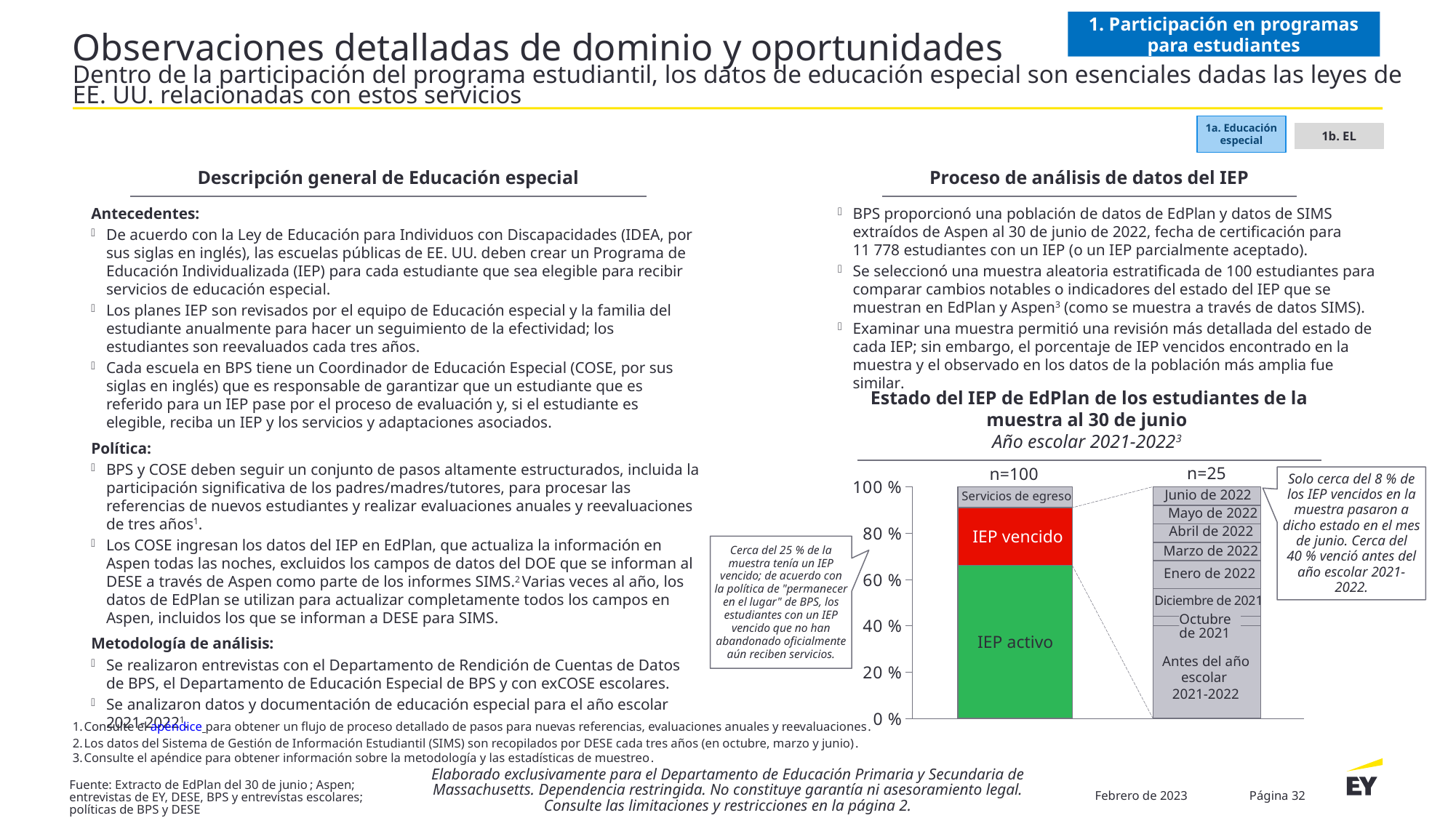
What kind of chart is shown on the slide? Stacked bar chart How many bars does the chart show? 2 What is the title of the chart on the slide? Estado del IEP de EdPlan de los estudiantes de la muestra al 30 de junio In the n=100 bar, which segment is larger: IEP activo or IEP vencido? IEP activo Is the share of IEP activo in the n=100 bar greater or less than 80 %? less How many segments make up the n=100 bar? 3 Is the share of Servicios de egreso in the n=100 bar greater or less than 20 %? less Which segment of the n=100 bar is the smallest? Servicios de egreso Is the share of IEP activo in the n=100 bar greater or less than 60 %? greater Which segment of the n=100 bar is the largest? IEP activo What is the highest value shown on the y axis of the chart? 100 % What sample size label appears above the second (right) bar? n=25